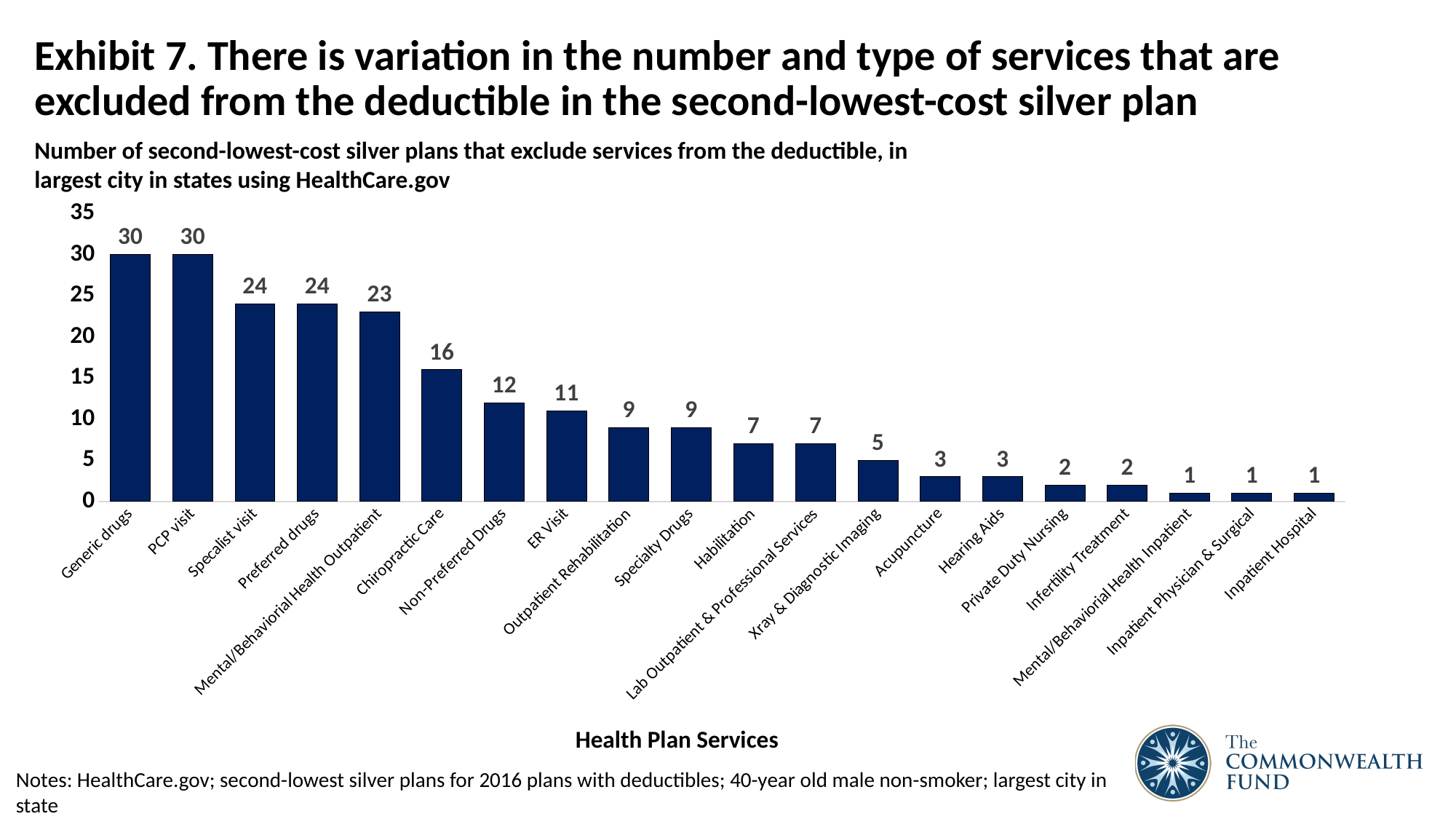
How many health plan services are shown on the x axis? 20 What is the value for Mental/Behavioral Health Outpatient? 23 Do the values rise or fall moving from left to right along the x axis? fall What kind of chart is shown on the slide? bar chart What is the value for ER Visit? 11 What is the highest value shown on the chart? 30 What is the difference between the values for Specialist visit and Non-Preferred Drugs? 12 What is the x-axis title of the chart? Health Plan Services What is the difference between the values for Generic drugs and Inpatient Hospital? 29 Which has a larger value, Habilitation or Acupuncture? Habilitation What is the value for Xray & Diagnostic Imaging? 5 What is the value for Chiropractic Care? 16